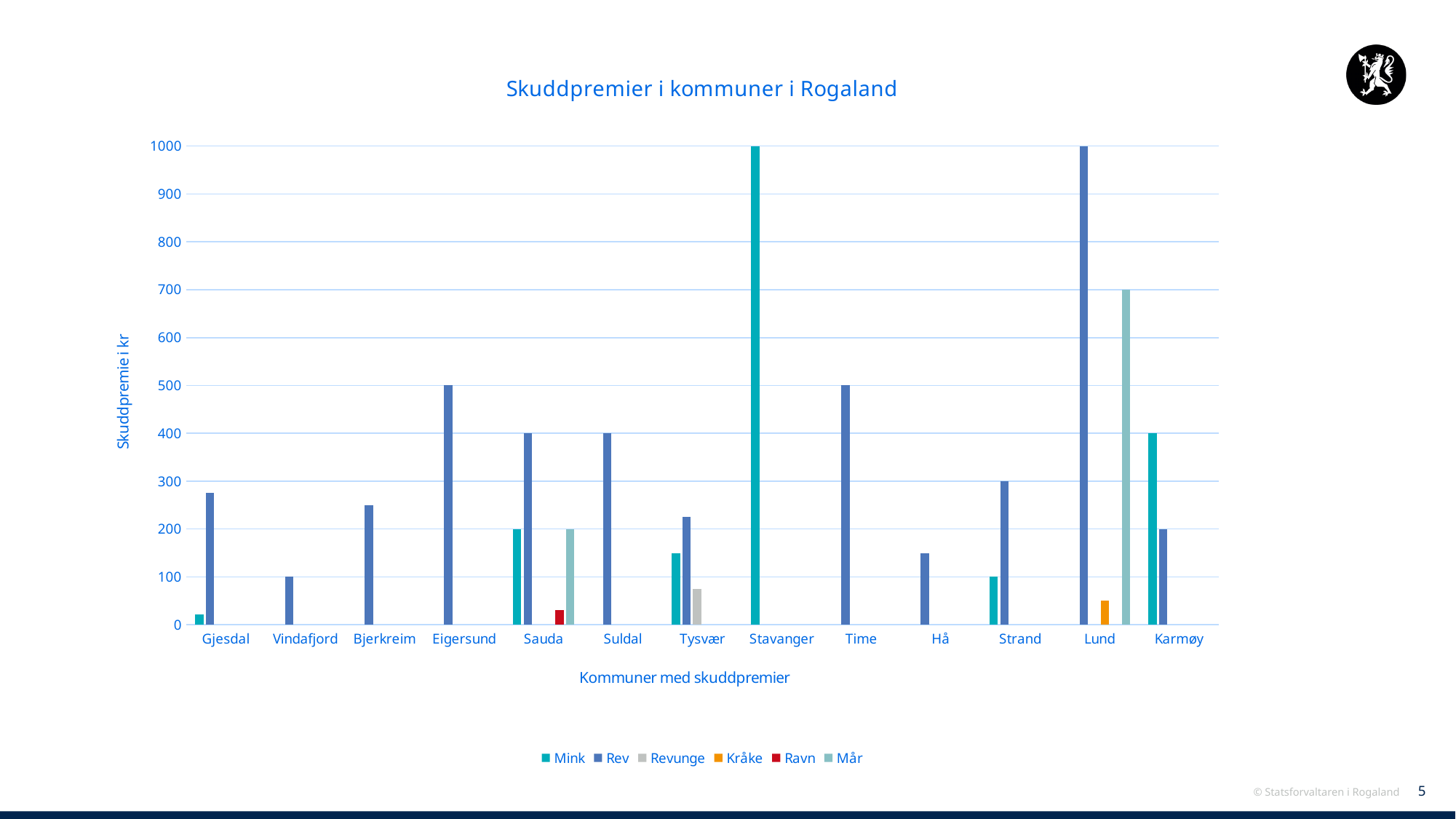
How many series does the legend list? 6 What is the difference between the Rev value for Lund and the Rev value for Strand? 700 Which is larger, the Rev value for Eigersund or the Rev value for Strand? Eigersund What is the Mink value for Stavanger? 1000 Which kommune has the highest Rev value? Lund Is the Revunge value for Tysvær greater or less than 100? less What is the Mår value for Lund? 700 What is the Rev value for Eigersund? 500 How many kommuner (categories) are shown on the x axis? 13 Is the Rev value for Gjesdal greater or less than 300? less What is the title of the chart? Skuddpremier i kommuner i Rogaland What kind of chart is shown on the slide? bar chart